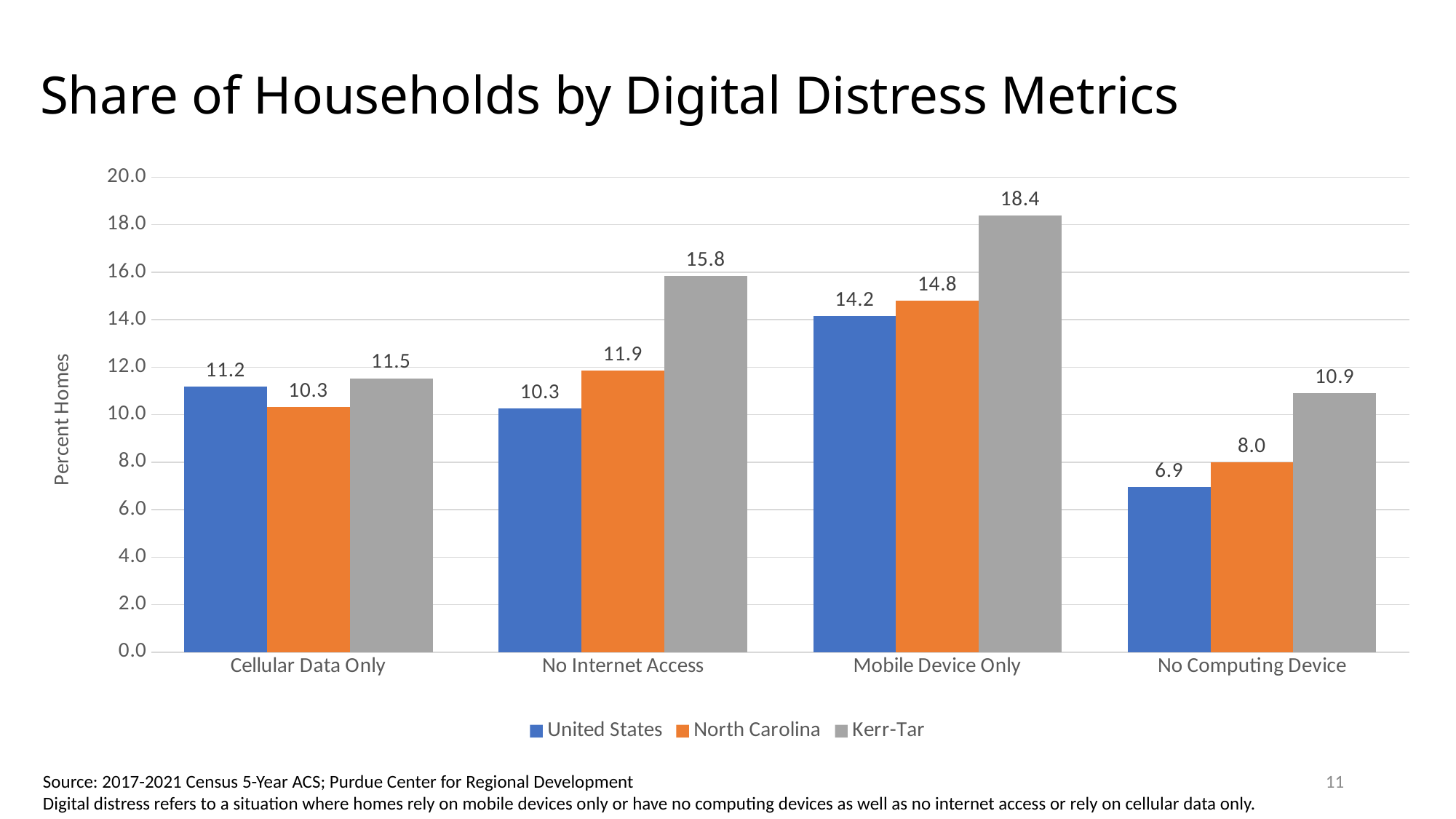
Which category has the highest Kerr-Tar value? Mobile Device Only What kind of chart is shown on the slide? Bar chart How many categories are shown on the x axis? 4 What is the value for North Carolina in the No Internet Access category? 11.9 How many series does the legend list? 3 What is the label of the y axis? Percent Homes Is the Kerr-Tar value for No Computing Device greater or less than 10.0? greater What is the difference between the Kerr-Tar and United States values for No Internet Access? 5.5 Which category has the lowest United States value? No Computing Device What is the value for the United States in the No Computing Device category? 6.9 What is the value for Kerr-Tar in the Mobile Device Only category? 18.4 Which is larger in the Cellular Data Only category: the United States value or the North Carolina value? United States